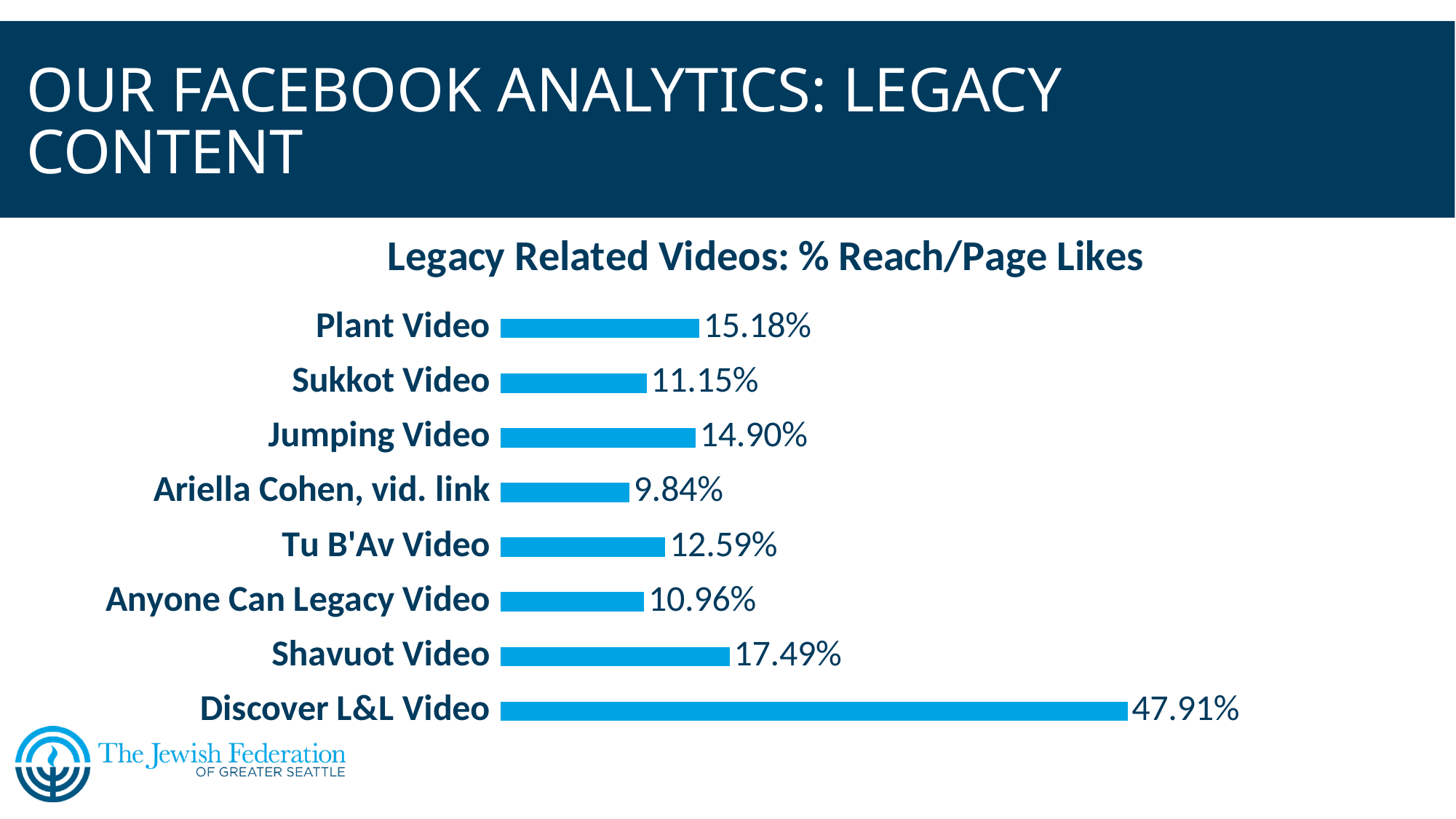
Which video has the highest % Reach/Page Likes? Discover L&L Video What is the difference between the Discover L&L Video and the Shavuot Video values? 30.42% What is the title of the chart? Legacy Related Videos: % Reach/Page Likes How many videos are shown in the chart? 8 What is the difference between the Plant Video and Jumping Video values? 0.28% What kind of chart is shown on the slide? Bar chart What is the value shown for the Sukkot Video? 11.15% Which video has the lowest % Reach/Page Likes? Ariella Cohen, vid. link What is the value for the Shavuot Video? 17.49% What value is shown for Ariella Cohen, vid. link? 9.84% Which has a larger value, the Tu B'Av Video or the Anyone Can Legacy Video? Tu B'Av Video What is the % Reach/Page Likes value for the Plant Video? 15.18%